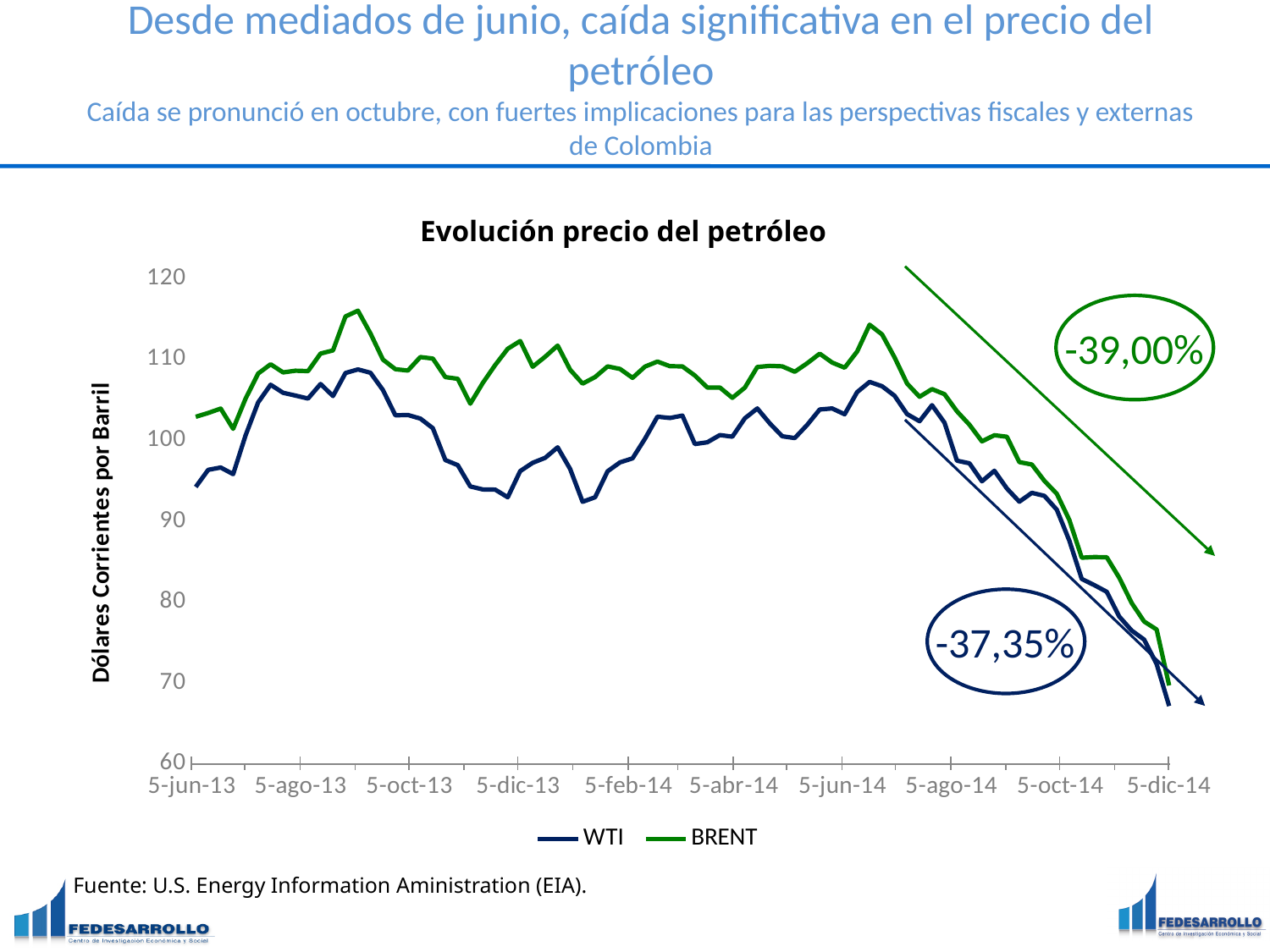
What is the title of the chart? Evolución precio del petróleo Which series reaches the higher peak value over the period shown? BRENT Do the oil prices rise or fall between 5-ago-14 and 5-dic-14? fall Is the BRENT value at 5-dic-14 greater or less than 80? less Is the highest BRENT value on the chart greater or less than 110? greater What percentage change is annotated next to the green (BRENT) line? -39,00% Is the highest WTI value on the chart greater or less than 110? less What kind of chart is shown on the slide? line chart At 5-jun-13, which series has the higher value, WTI or BRENT? BRENT How many series does the legend list? 2 What are the two series named in the legend? WTI and BRENT What percentage change is annotated next to the dark blue (WTI) line? -37,35%